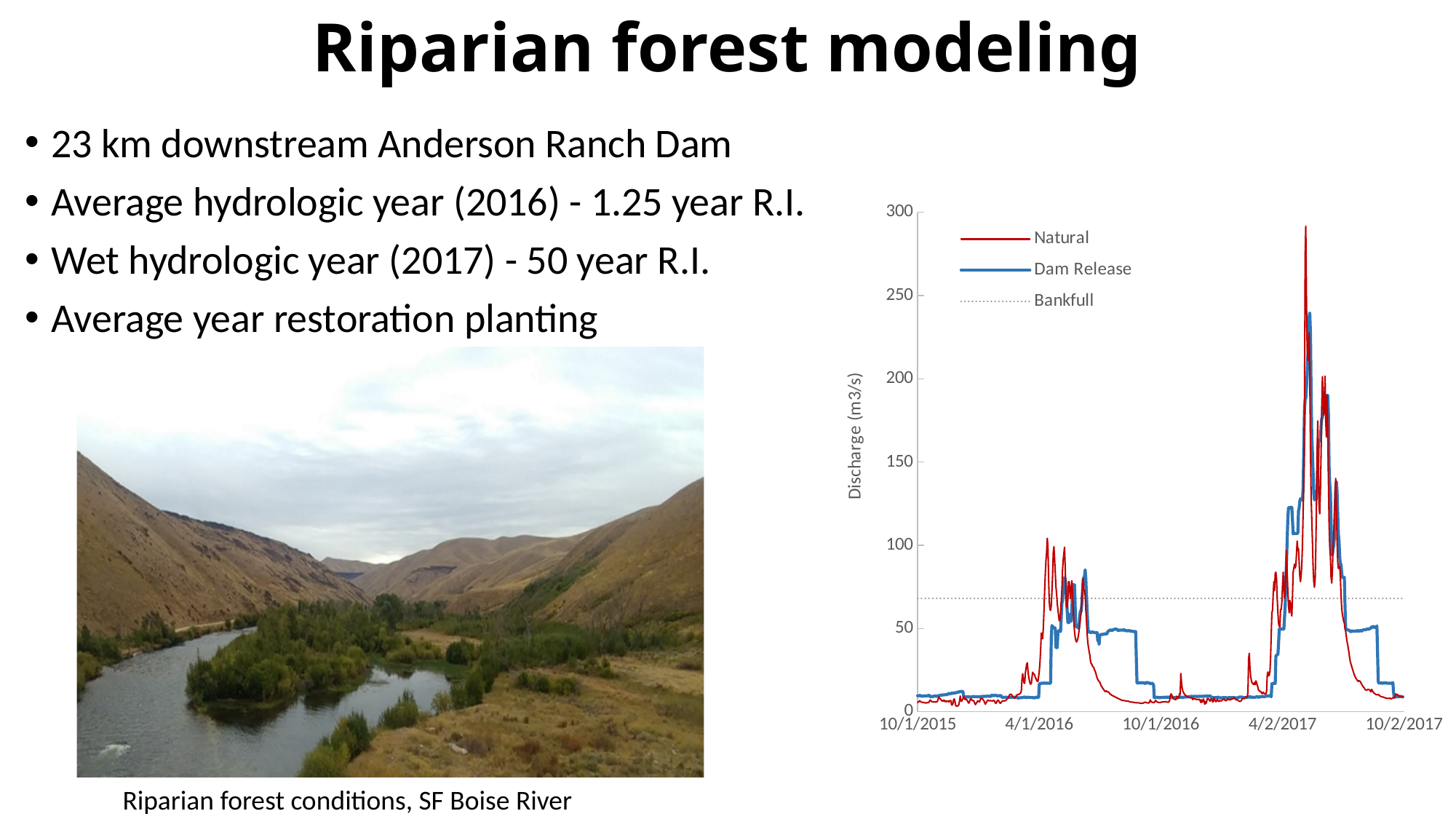
Is the highest peak of the Natural series greater or less than 250? greater Which spring has the higher peak discharge, spring 2016 or spring 2017? spring 2017 What are the three series named in the chart legend? Natural, Dam Release, Bankfull Is the peak of the Natural series in spring 2016 greater or less than 150? less Which series reaches the highest value on the chart, Natural or Dam Release? Natural What is the label on the vertical axis of the chart? Discharge (m3/s) What kind of chart is shown on the slide? line chart Is the Bankfull line greater or less than 100? less How many series does the chart legend list? 3